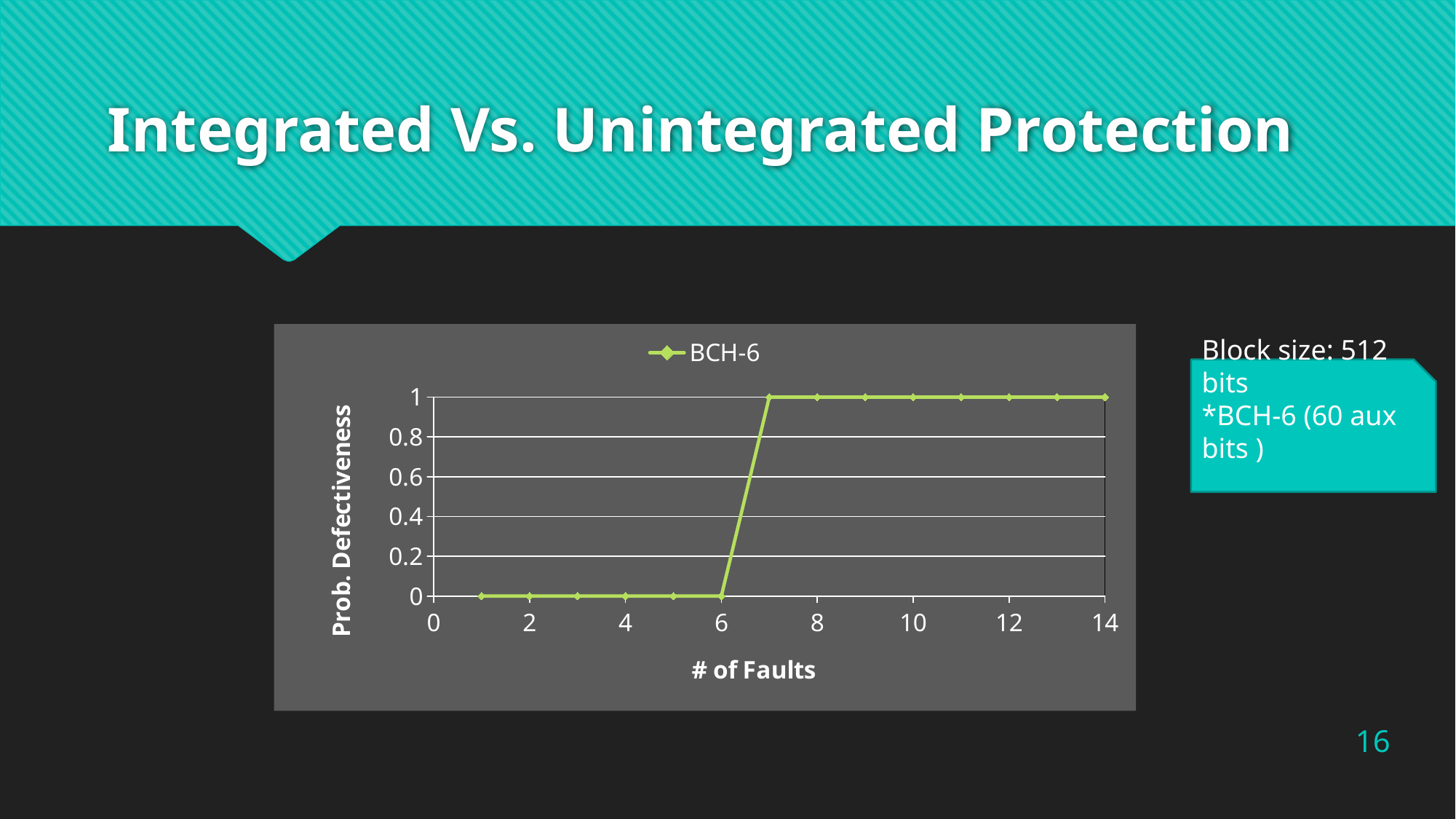
What is the Prob. Defectiveness for BCH-6 at 12 faults? 1 How many data points are plotted for the BCH-6 series? 14 What is the label of the y axis? Prob. Defectiveness What is the Prob. Defectiveness for BCH-6 at 7 faults? 1 What kind of chart is shown on the slide? line chart How many series does the legend list? 1 What is the name of the series shown in the legend? BCH-6 What is the Prob. Defectiveness for BCH-6 at 6 faults? 0 Which is larger for BCH-6: the Prob. Defectiveness at 5 faults or at 8 faults? 8 faults Does the Prob. Defectiveness for BCH-6 rise or fall as the number of faults increases from 6 to 7? rise What is the difference in Prob. Defectiveness for BCH-6 between 10 faults and 3 faults? 1 What is the Prob. Defectiveness for BCH-6 at 2 faults? 0